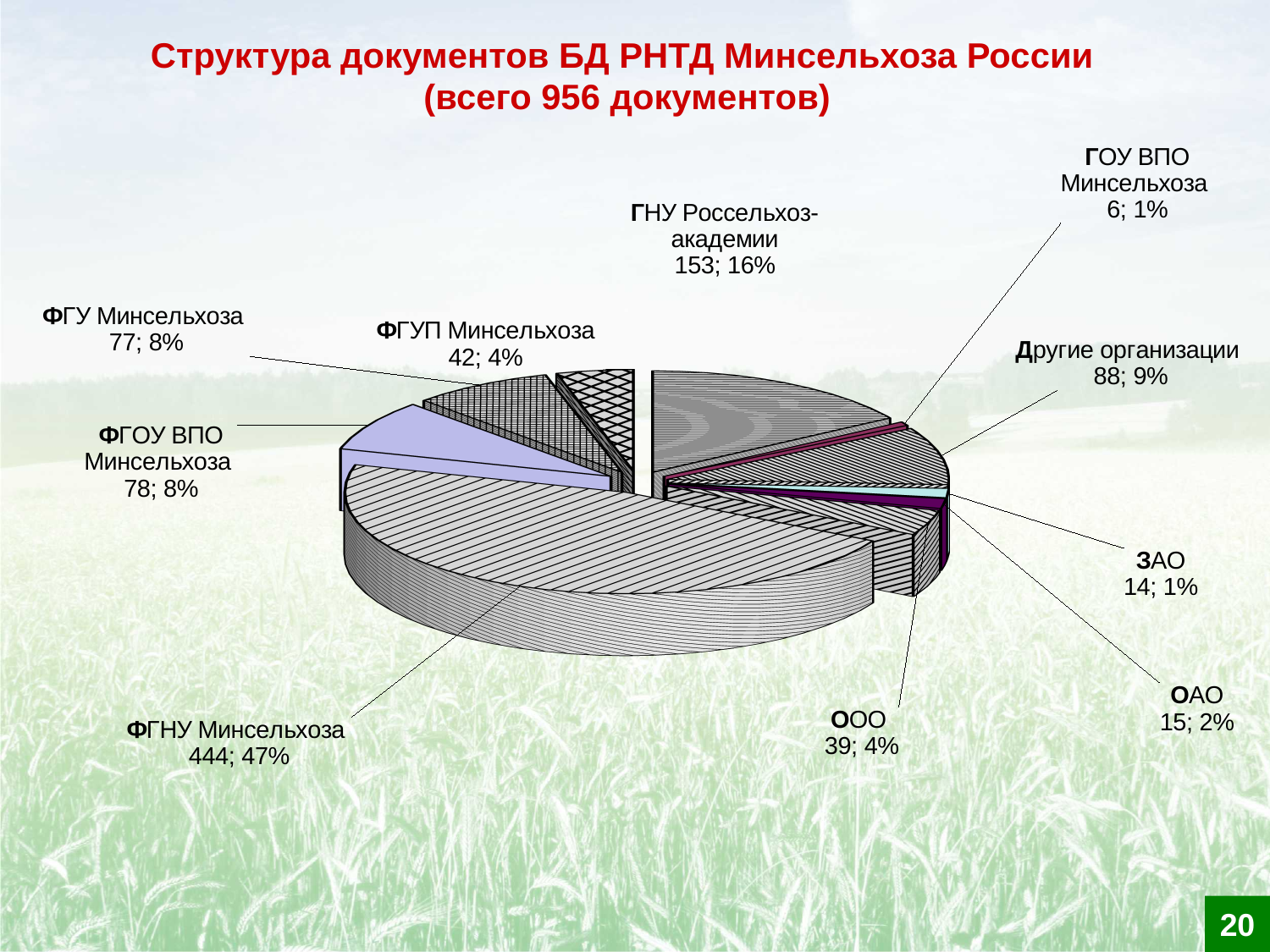
How many documents does the ФГНУ Минсельхоза slice represent? 444 What is the difference in document count between ФГОУ ВПО Минсельхоза and ФГУ Минсельхоза? 1 How many documents does the ЗАО slice represent? 14 What share of the pie does ГНУ Россельхозакадемии hold? 16% Which category has the largest slice of the pie? ФГНУ Минсельхоза What share of the pie does Другие организации hold? 9% How many categories are shown in the pie chart? 10 What is the difference in document count between ГНУ Россельхозакадемии and Другие организации? 65 What is the total number of documents stated in the chart title? 956 What kind of chart is shown on the slide? pie chart Which has more documents, ООО or ОАО? ООО Which category has the smallest slice of the pie? ГОУ ВПО Минсельхоза